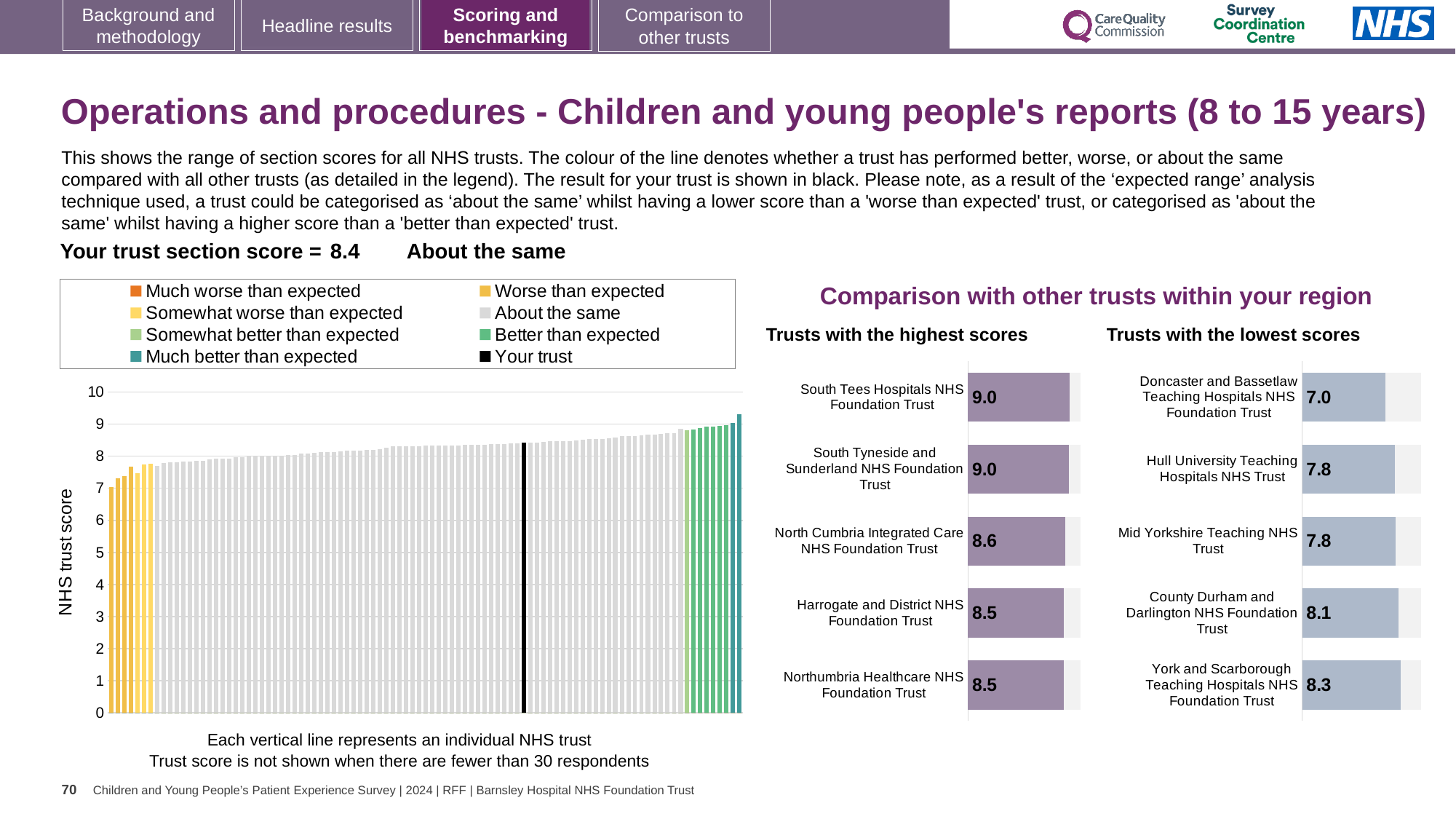
How many trusts are shown in the 'Trusts with the lowest scores' chart? 5 How many trusts are shown in the 'Trusts with the highest scores' chart? 5 What kind of chart is the main NHS trust score chart on the left of the slide? Bar chart In the 'Trusts with the lowest scores' chart, which trust has the highest score? York and Scarborough Teaching Hospitals NHS Foundation Trust In the 'Trusts with the lowest scores' chart, what is the score for Doncaster and Bassetlaw Teaching Hospitals NHS Foundation Trust? 7.0 In the 'Trusts with the lowest scores' chart, what is the difference between the scores of York and Scarborough Teaching Hospitals NHS Foundation Trust and Doncaster and Bassetlaw Teaching Hospitals NHS Foundation Trust? 1.3 In the 'Trusts with the lowest scores' chart, which trust has the lowest score? Doncaster and Bassetlaw Teaching Hospitals NHS Foundation Trust In the 'Trusts with the highest scores' chart, what is the difference between the scores of South Tees Hospitals NHS Foundation Trust and Harrogate and District NHS Foundation Trust? 0.5 In the 'Trusts with the highest scores' chart, what is the score for North Cumbria Integrated Care NHS Foundation Trust? 8.6 In the main NHS trust score chart on the left, do the values rise or fall from left to right? Rise In the 'Trusts with the lowest scores' chart, which has the larger score: Hull University Teaching Hospitals NHS Trust or County Durham and Darlington NHS Foundation Trust? County Durham and Darlington NHS Foundation Trust How many entries does the legend of the main NHS trust score chart on the left list? 8